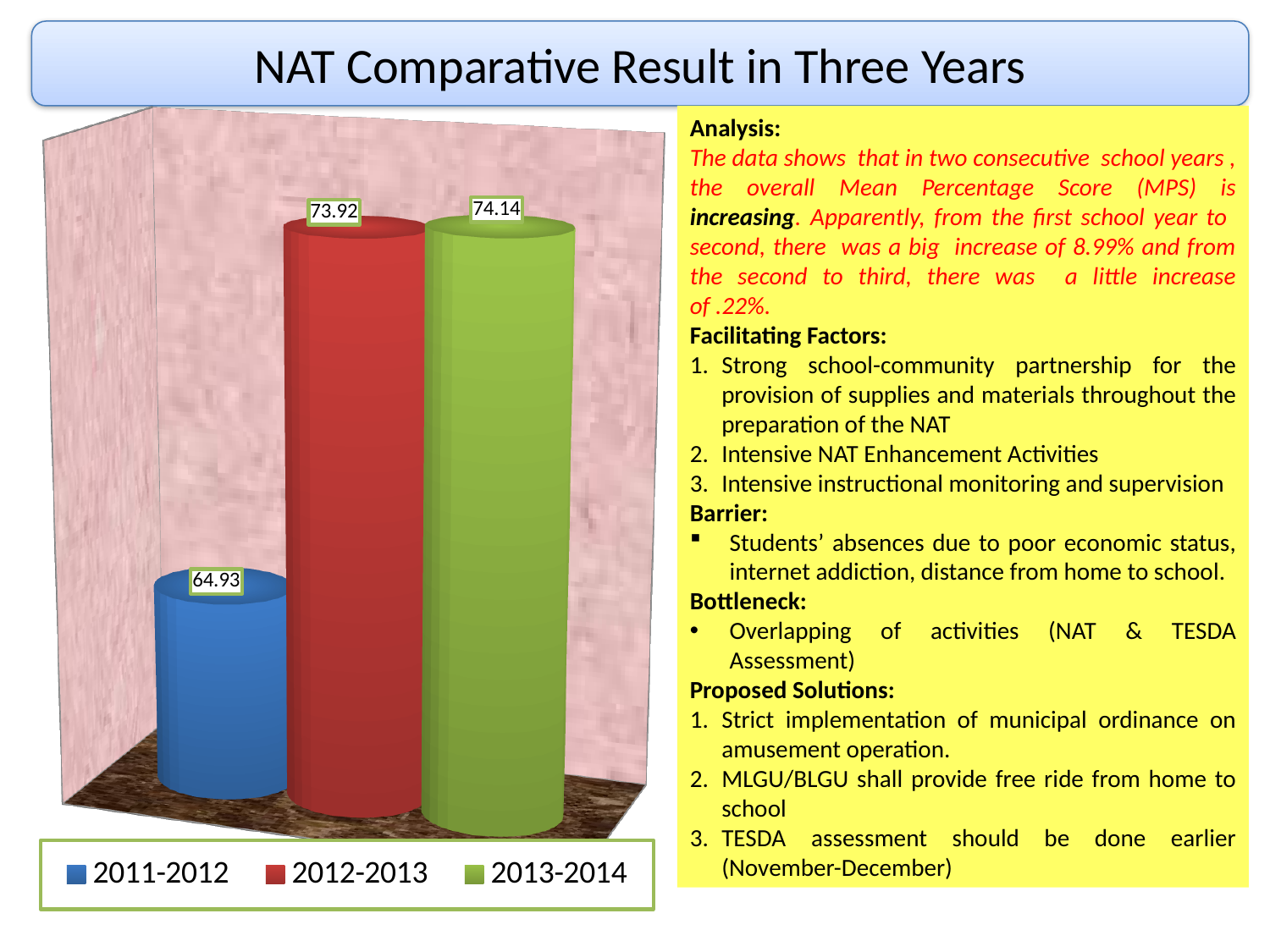
Do the values rise or fall from 2011-2012 to 2013-2014? Rise Which school year has the lowest value? 2011-2012 What kind of chart is shown on the slide? Bar chart What is the difference between the values for 2013-2014 and 2012-2013? 0.22 Which is larger, the value for 2011-2012 or the value for 2012-2013? 2012-2013 What is the difference between the values for 2012-2013 and 2011-2012? 8.99 How many entries does the legend list? 3 How many bars are plotted in the chart? 3 Which school year has the highest value according to the data labels? 2013-2014 What is the value for 2012-2013? 73.92 What is the value for 2013-2014? 74.14 What is the value for 2011-2012? 64.93